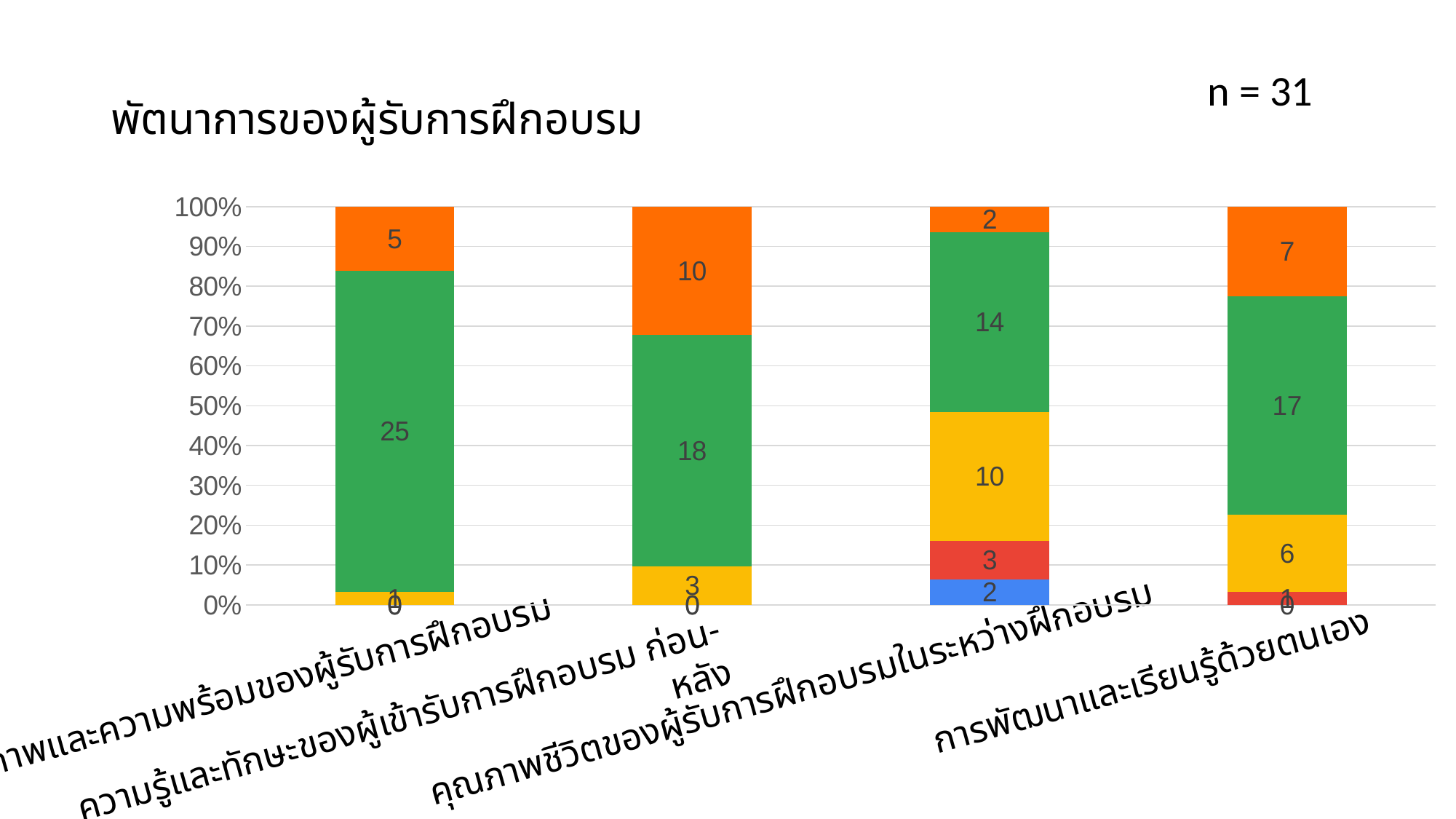
Which category has the smallest orange segment? คุณภาพชีวิตของผู้รับการฝึกอบรมในระหว่างฝึกอบรม Which category has the largest orange segment? ความรู้และทักษะของผู้เข้ารับการฝึกอบรม ก่อน-หลัง What sample size (n) is stated on the slide? n = 31 What is the difference between the orange segment of "การพัฒนาและเรียนรู้ด้วยตนเอง" and the orange segment of "คุณภาพชีวิตของผู้รับการฝึกอบรมในระหว่างฝึกอบรม"? 5 What type of chart is shown on the slide? Stacked bar chart How many categories (bars) are plotted in the chart? 4 Which has the larger green segment: "ความรู้และทักษะของผู้เข้ารับการฝึกอบรม ก่อน-หลัง" or "การพัฒนาและเรียนรู้ด้วยตนเอง"? ความรู้และทักษะของผู้เข้ารับการฝึกอบรม ก่อน-หลัง What is the value of the orange segment for "ความรู้และทักษะของผู้เข้ารับการฝึกอบรม ก่อน-หลัง"? 10 What is the value of the green segment for "การพัฒนาและเรียนรู้ด้วยตนเอง"? 17 What is the value of the yellow segment for "คุณภาพชีวิตของผู้รับการฝึกอบรมในระหว่างฝึกอบรม"? 10 What is the total of all segments in the bar for "คุณภาพชีวิตของผู้รับการฝึกอบรมในระหว่างฝึกอบรม"? 31 What is the value of the blue segment for "คุณภาพชีวิตของผู้รับการฝึกอบรมในระหว่างฝึกอบรม"? 2